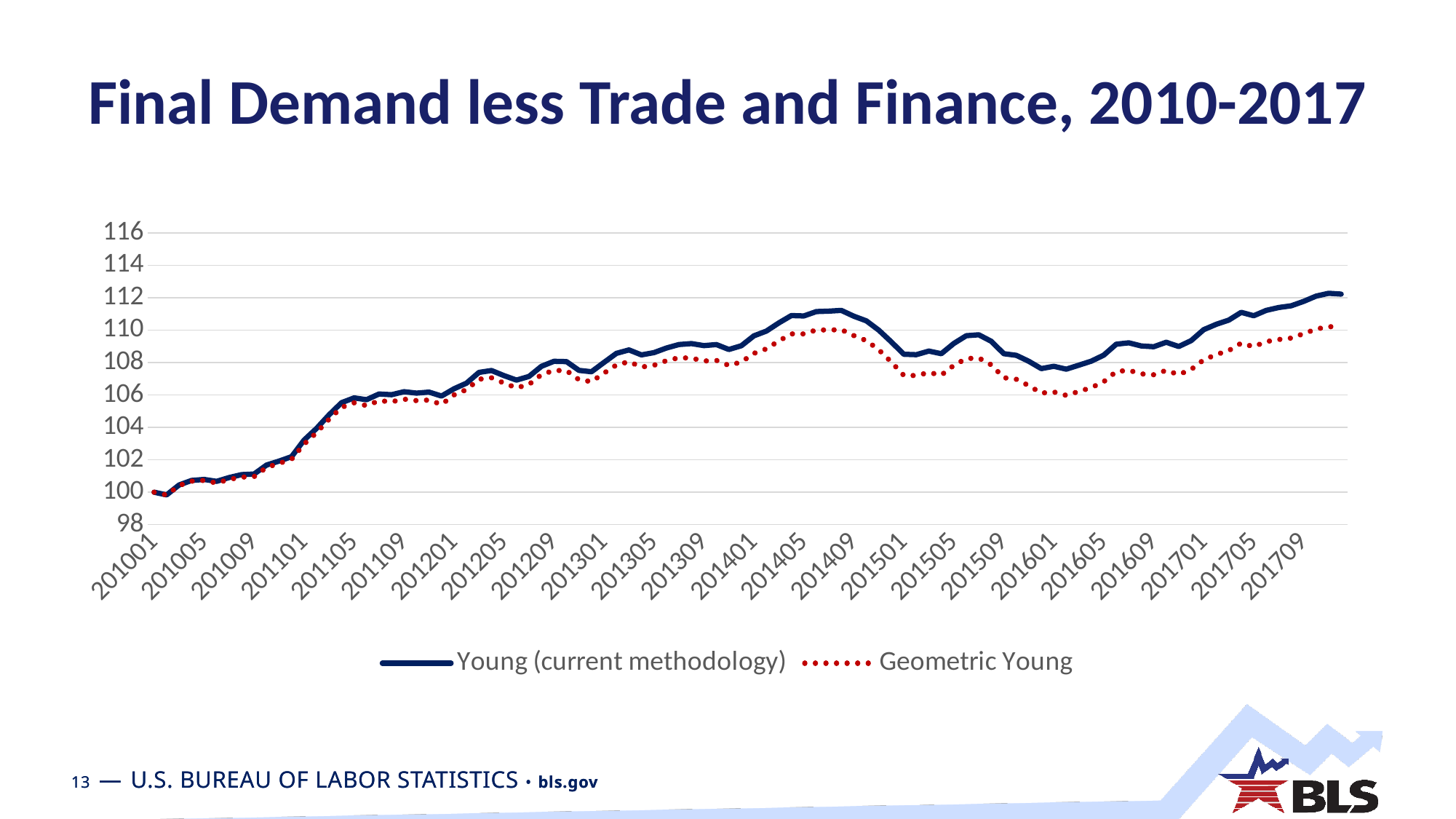
Is the value of Young (current methodology) at 201405 greater or less than 110? greater Is the value of Young (current methodology) at 201709 greater or less than 110? greater Does the Young (current methodology) series generally rise or fall from 201001 to 201709? rise What is the title of the chart? Final Demand less Trade and Finance, 2010-2017 Is the value of Young (current methodology) at 201101 greater or less than 104? less What is the value of the Young (current methodology) series at 201001? 100 At 201601, which series has the higher value, Young (current methodology) or Geometric Young? Young (current methodology) How many series does the legend list? 2 What kind of chart is shown on the slide? line chart Which series is drawn as a red dotted line? Geometric Young